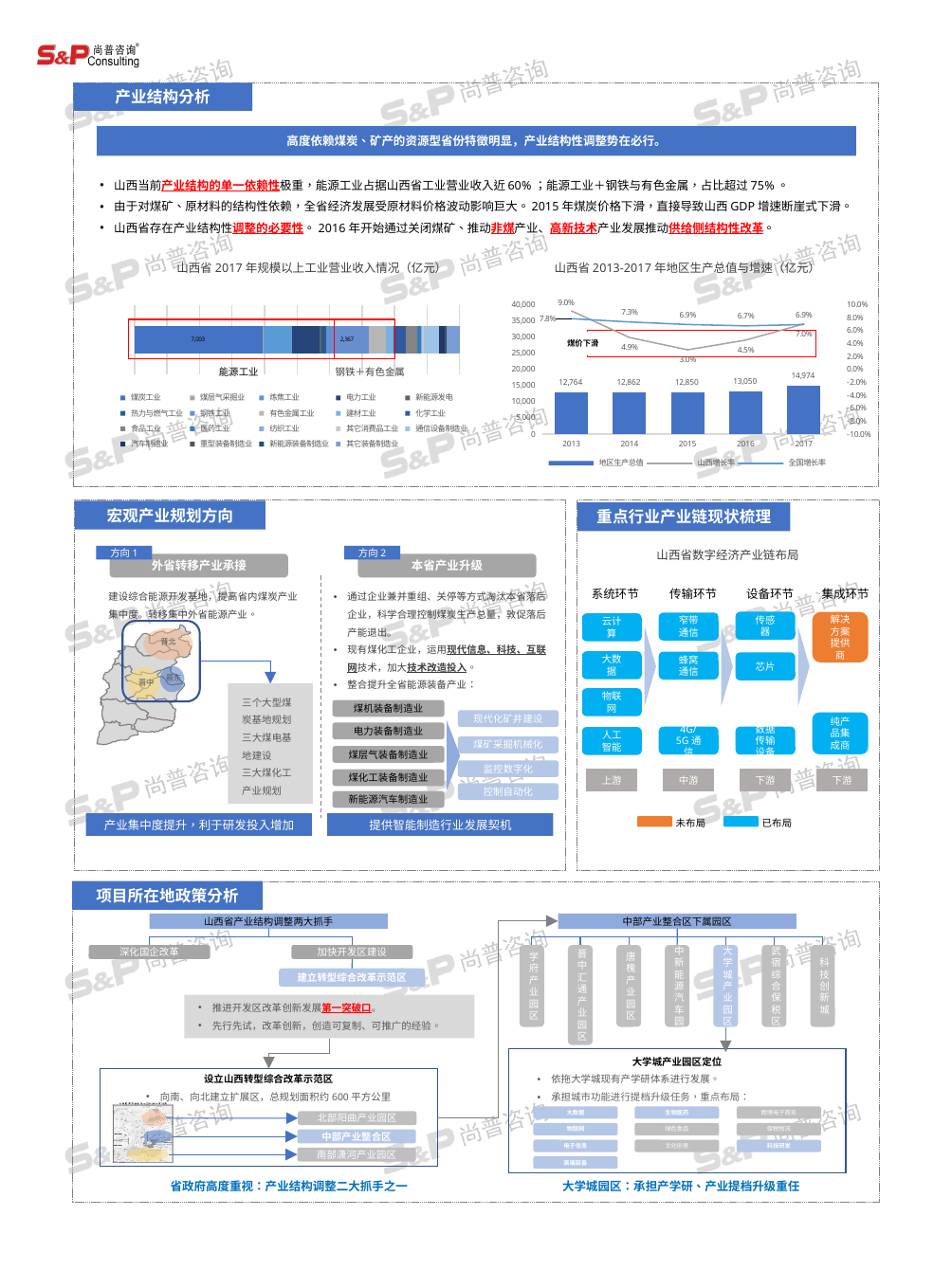
What kind of chart is the one titled 山西省2017年规模以上工业营业收入情况（亿元）? Stacked bar chart In the chart titled 山西省2013-2017年地区生产总值与增速（亿元）, what is the 全国增长率 for 2013? 7.8% In the chart titled 山西省2013-2017年地区生产总值与增速（亿元）, what is the 地区生产总值 value for 2017? 14,974 In the chart titled 山西省2013-2017年地区生产总值与增速（亿元）, which is larger in 2014, the 山西增长率 or the 全国增长率? 全国增长率 In the chart titled 山西省2013-2017年地区生产总值与增速（亿元）, which year has the highest 地区生产总值? 2017 In the chart titled 山西省2013-2017年地区生产总值与增速（亿元）, what is the 山西增长率 for 2015? 3.0% In the chart titled 山西省2017年规模以上工业营业收入情况（亿元）, what is the value labelled on the 煤炭工业 segment? 7,003 In the chart titled 山西省2013-2017年地区生产总值与增速（亿元）, which year has the lowest 地区生产总值? 2013 In the chart titled 山西省2013-2017年地区生产总值与增速（亿元）, how many years are shown on the x axis? 5 In the chart titled 山西省2013-2017年地区生产总值与增速（亿元）, what is the 地区生产总值 value for 2013? 12,764 In the chart titled 山西省2013-2017年地区生产总值与增速（亿元）, what is the difference between the 地区生产总值 of 2017 and 2016? 1,924 In the chart titled 山西省2013-2017年地区生产总值与增速（亿元）, how many series does the legend list? 3